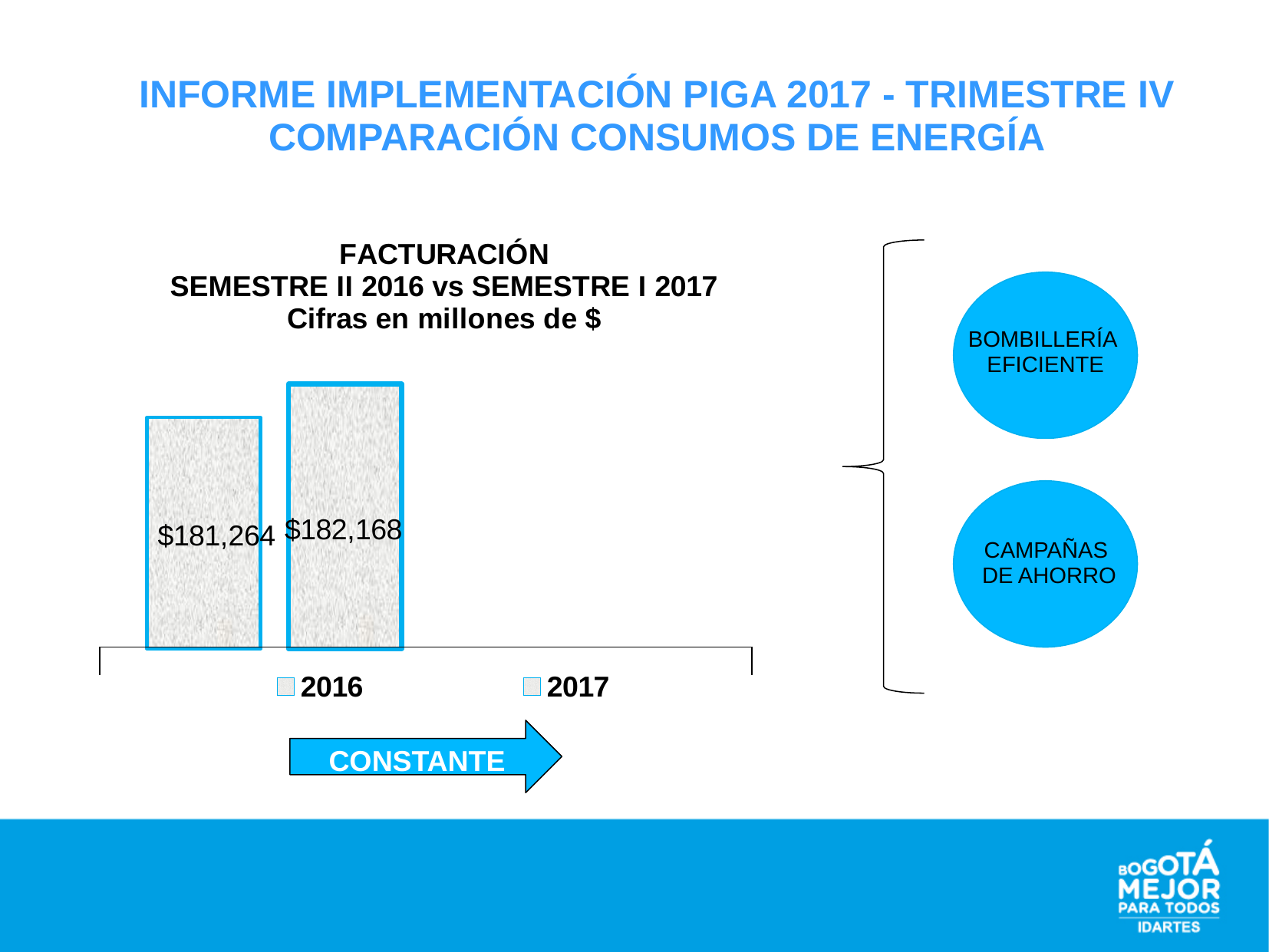
What are the two entries listed in the legend of the FACTURACIÓN chart? 2016 and 2017 What is the difference between the 2017 and 2016 values in the FACTURACIÓN chart? $904 What is the value shown for 2016 in the FACTURACIÓN chart? $181,264 Which year has the lower value in the FACTURACIÓN chart? 2016 How many bars are plotted in the FACTURACIÓN chart? 2 Do the values in the FACTURACIÓN chart rise or fall from 2016 to 2017? rise What is the value shown for 2017 in the FACTURACIÓN chart? $182,168 What unit does the FACTURACIÓN chart title say the figures are in? millones de $ Is the value for 2017 larger or smaller than the value for 2016 in the FACTURACIÓN chart? larger What kind of chart is the FACTURACIÓN chart? bar chart Which year has the higher value in the FACTURACIÓN chart? 2017 How many series does the legend of the FACTURACIÓN chart list? 2